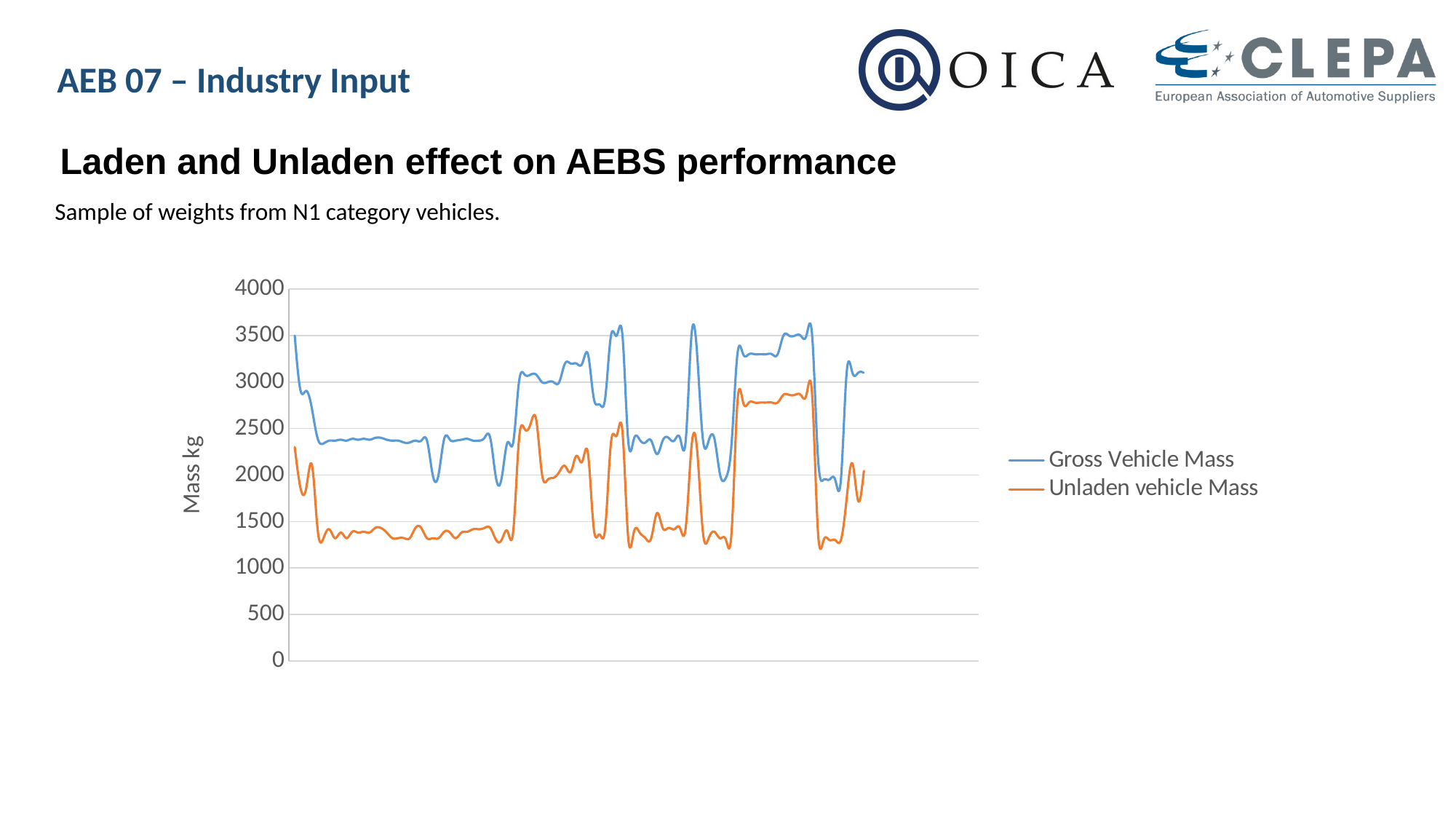
What is the label on the chart's vertical axis? Mass kg Is the lowest point of the Gross Vehicle Mass line greater or less than 1500? greater What are the two series named in the chart's legend? Gross Vehicle Mass and Unladen vehicle Mass Is the lowest point of the Unladen vehicle Mass line greater or less than 1500? less How many series does the chart's legend list? 2 Which series is plotted higher across the chart, Gross Vehicle Mass or Unladen vehicle Mass? Gross Vehicle Mass Is the highest point of the Unladen vehicle Mass line greater or less than 3500? less What is the highest value shown on the chart's vertical axis? 4000 What kind of chart is shown on the slide? line chart